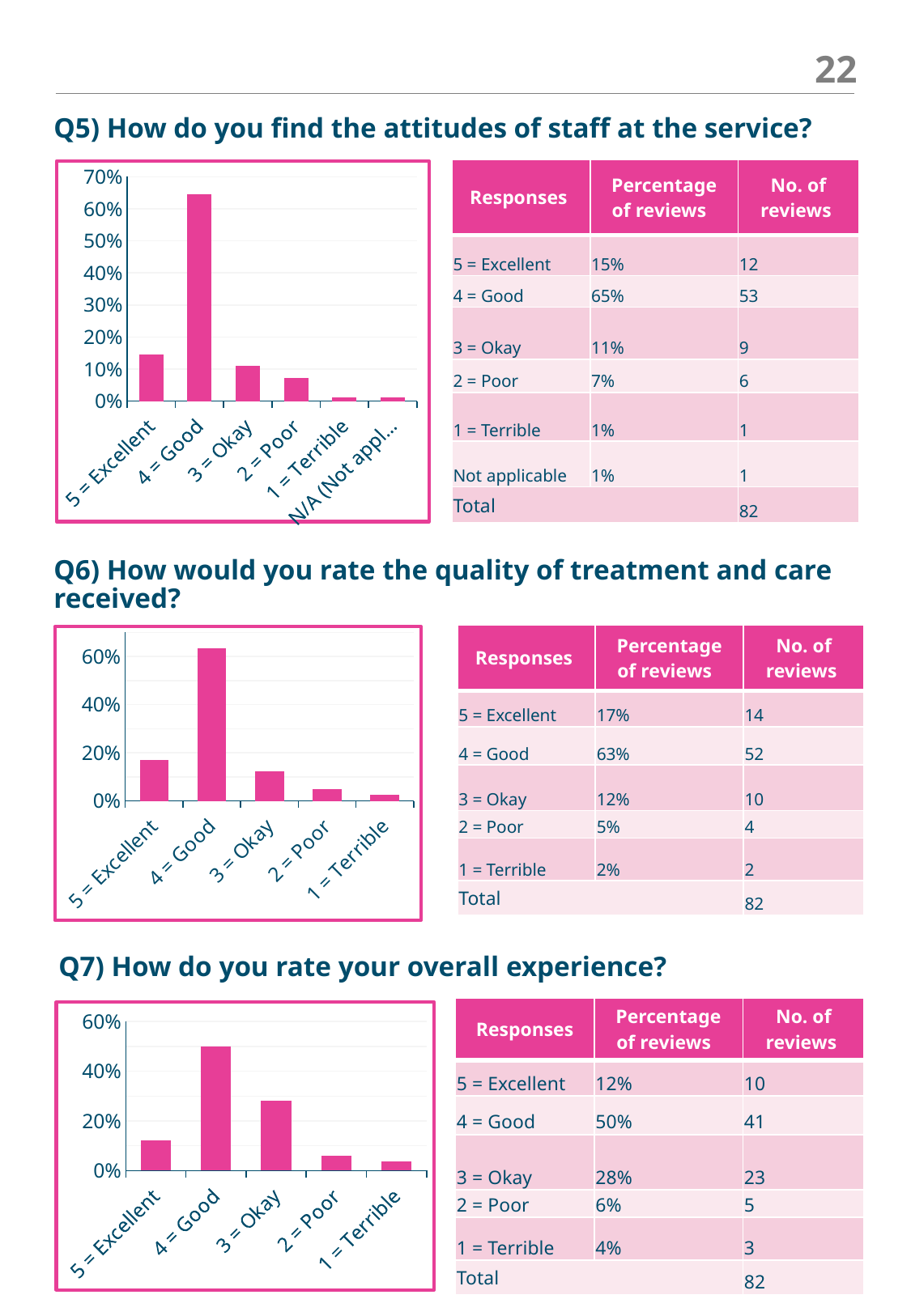
What kind of chart is used for Q7 (overall experience)? bar chart In the Q6 chart (quality of treatment and care), is the value for 5 = Excellent greater or less than 20%? less In the Q6 chart (quality of treatment and care), what is the difference between the percentages for 4 = Good and 5 = Excellent? 46% In the Q7 chart (overall experience), what percentage of reviews is shown for 4 = Good? 50% In the Q5 chart (attitudes of staff), which category has the highest bar? 4 = Good In the Q7 chart (overall experience), how many categories are shown on the x axis? 5 In the Q6 chart (quality of treatment and care), which category has the lowest bar? 1 = Terrible In the Q5 chart (attitudes of staff), how many categories are shown on the x axis? 6 In the Q5 chart (attitudes of staff), is the value for 4 = Good greater or less than 60%? greater In the Q7 chart (overall experience), which is larger, the value for 3 = Okay or the value for 5 = Excellent? 3 = Okay In the Q7 chart (overall experience), is the value for 3 = Okay greater or less than 20%? greater In the Q5 chart (attitudes of staff), what percentage of reviews is shown for 5 = Excellent? 15%